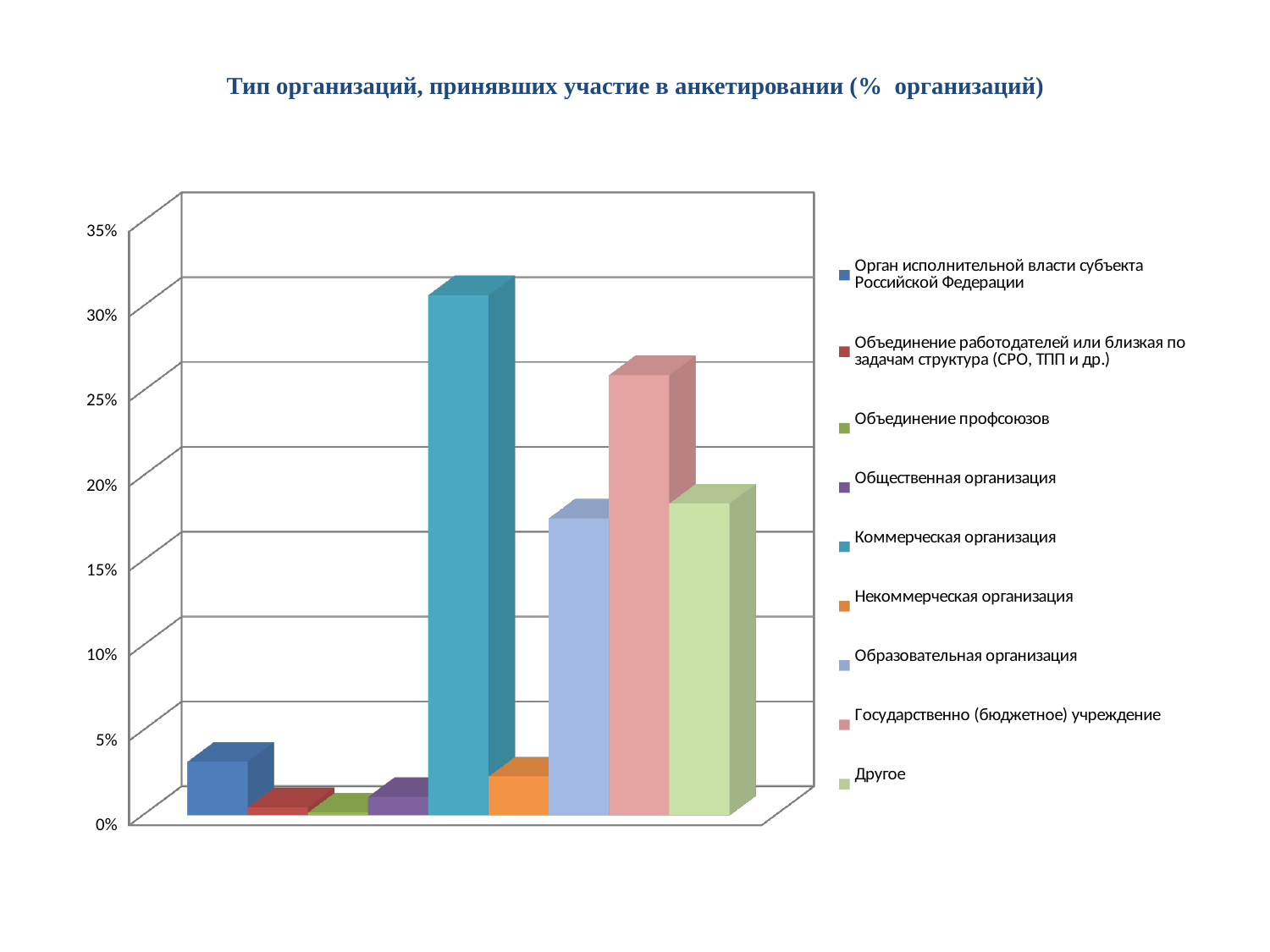
Which is larger: the value for Коммерческая организация or for Другое? Коммерческая организация What kind of chart is shown on the slide? bar chart Is the value for Коммерческая организация greater or less than 25%? greater Is the value for Государственно (бюджетное) учреждение greater or less than 20%? greater What is the title of the chart? Тип организаций, принявших участие в анкетировании (% организаций) Is the value for Некоммерческая организация greater or less than 10%? less How many series does the legend list? 9 What is the highest value shown on the vertical axis? 35% Which organisation type has the highest value? Коммерческая организация Which is larger: the value for Государственно (бюджетное) учреждение or for Образовательная организация? Государственно (бюджетное) учреждение